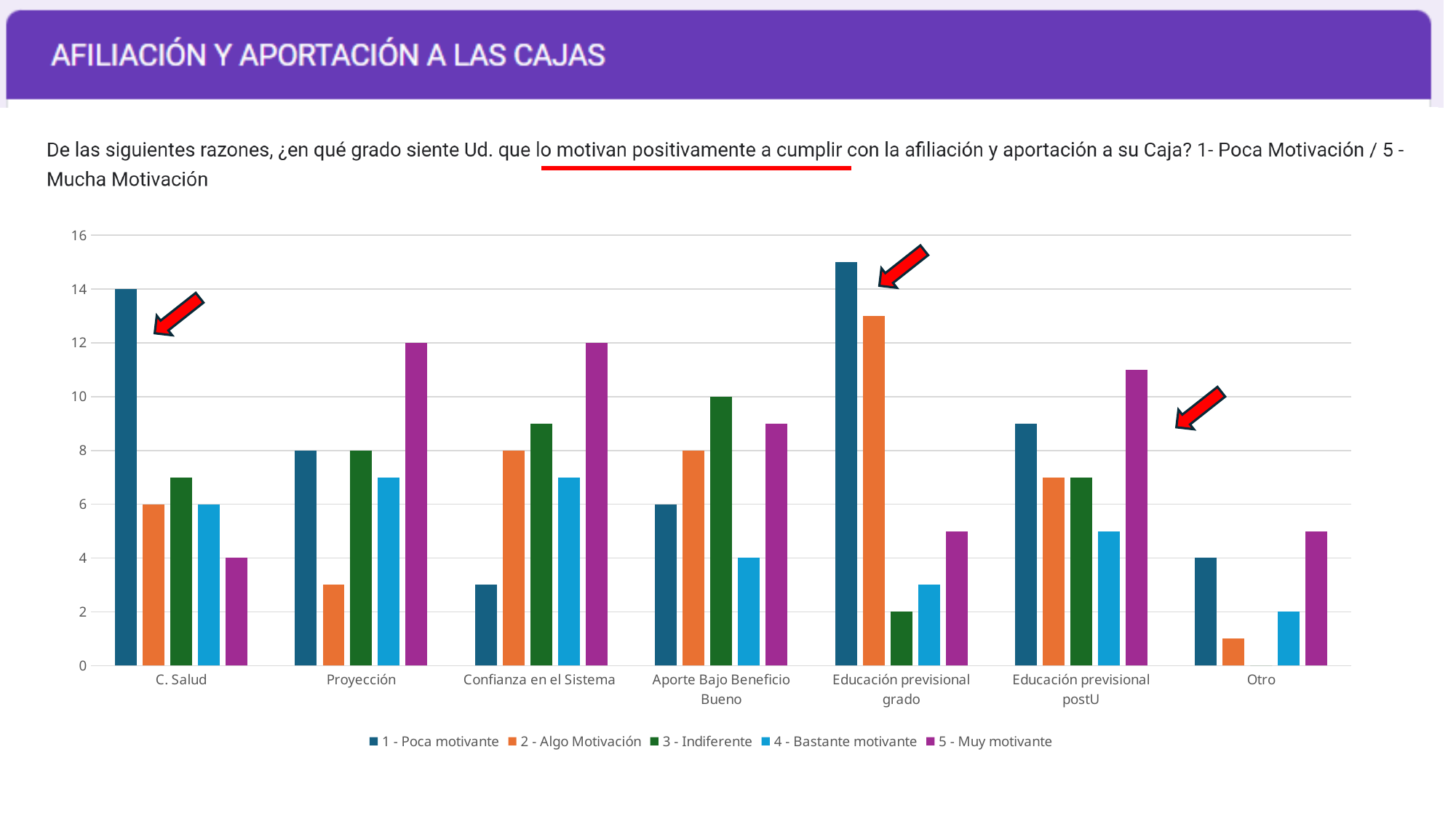
What is the value of '5 - Muy motivante' for Proyección? 12 What is the value of '4 - Bastante motivante' for Otro? 2 Which series has the highest value for C. Salud? 1 - Poca motivante What is the value of '3 - Indiferente' for Aporte Bajo Beneficio Bueno? 10 What is the value of '1 - Poca motivante' for C. Salud? 14 Is the value of '5 - Muy motivante' for Educación previsional postU greater or less than 10? greater What type of chart is shown on the slide? bar chart How many series does the chart legend list? 5 Is the value of '1 - Poca motivante' for Educación previsional grado greater or less than 14? greater How many categories are shown along the x axis of the chart? 7 Which series has the lowest value for Proyección? 2 - Algo Motivación What is the difference between '1 - Poca motivante' and '4 - Bastante motivante' for C. Salud? 8